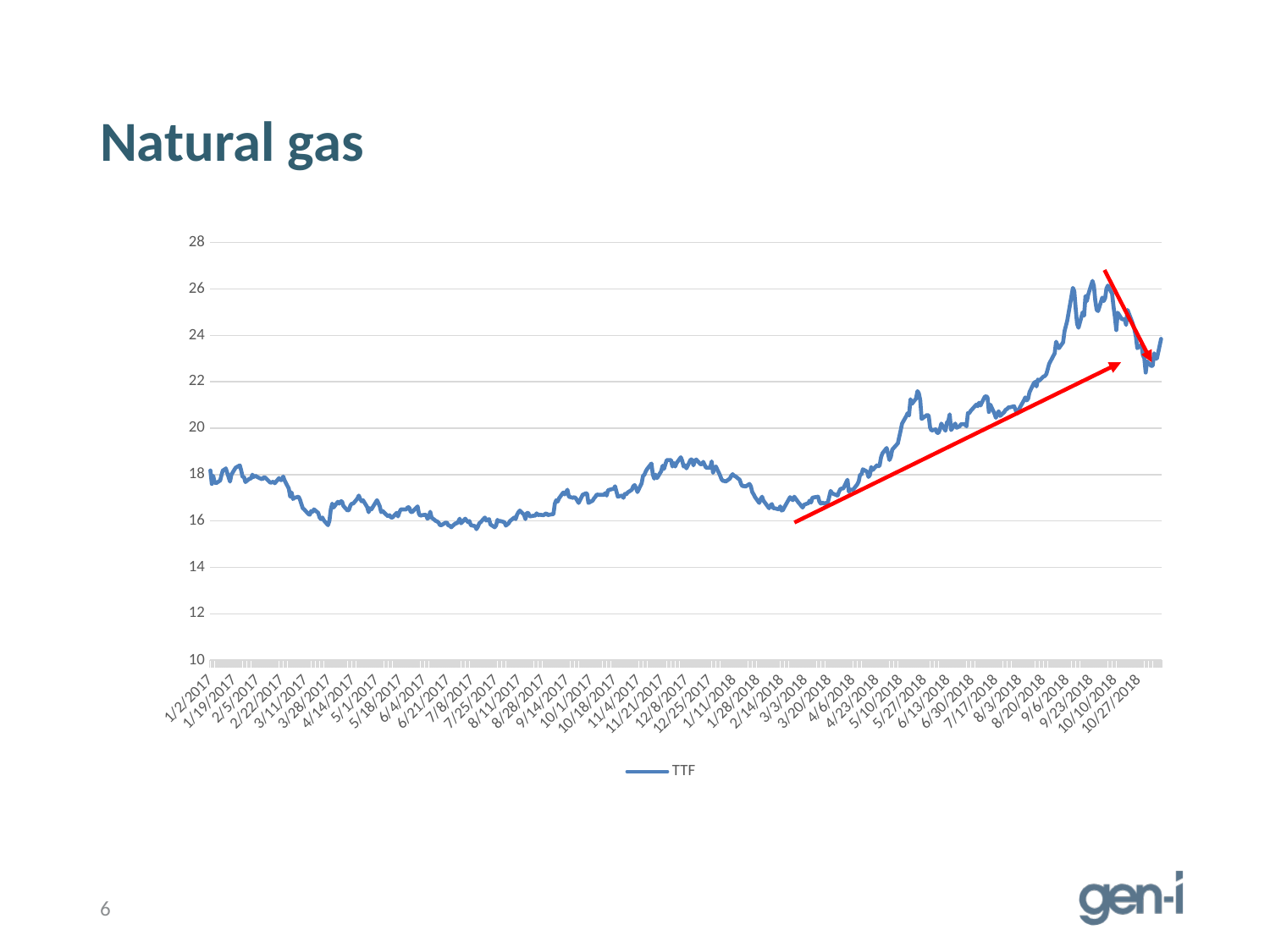
What is the name of the series shown in the legend? TTF What kind of chart is shown on the slide? line chart How many series does the legend list? 1 Is the TTF value at 1/2/2017 greater or less than 16? greater Overall, does the TTF line rise or fall from the start of 2017 to the end of the series in 2018? rise Is the lowest point of the TTF line greater or less than 16? less What is the title of the slide containing the chart? Natural gas In which year does the TTF line reach its highest value? 2018 Is the TTF value around 9/23/2018 greater or less than 24? greater Which is higher, the TTF value at the start of the series (1/2/2017) or at the end (late October 2018)? the end (late October 2018)